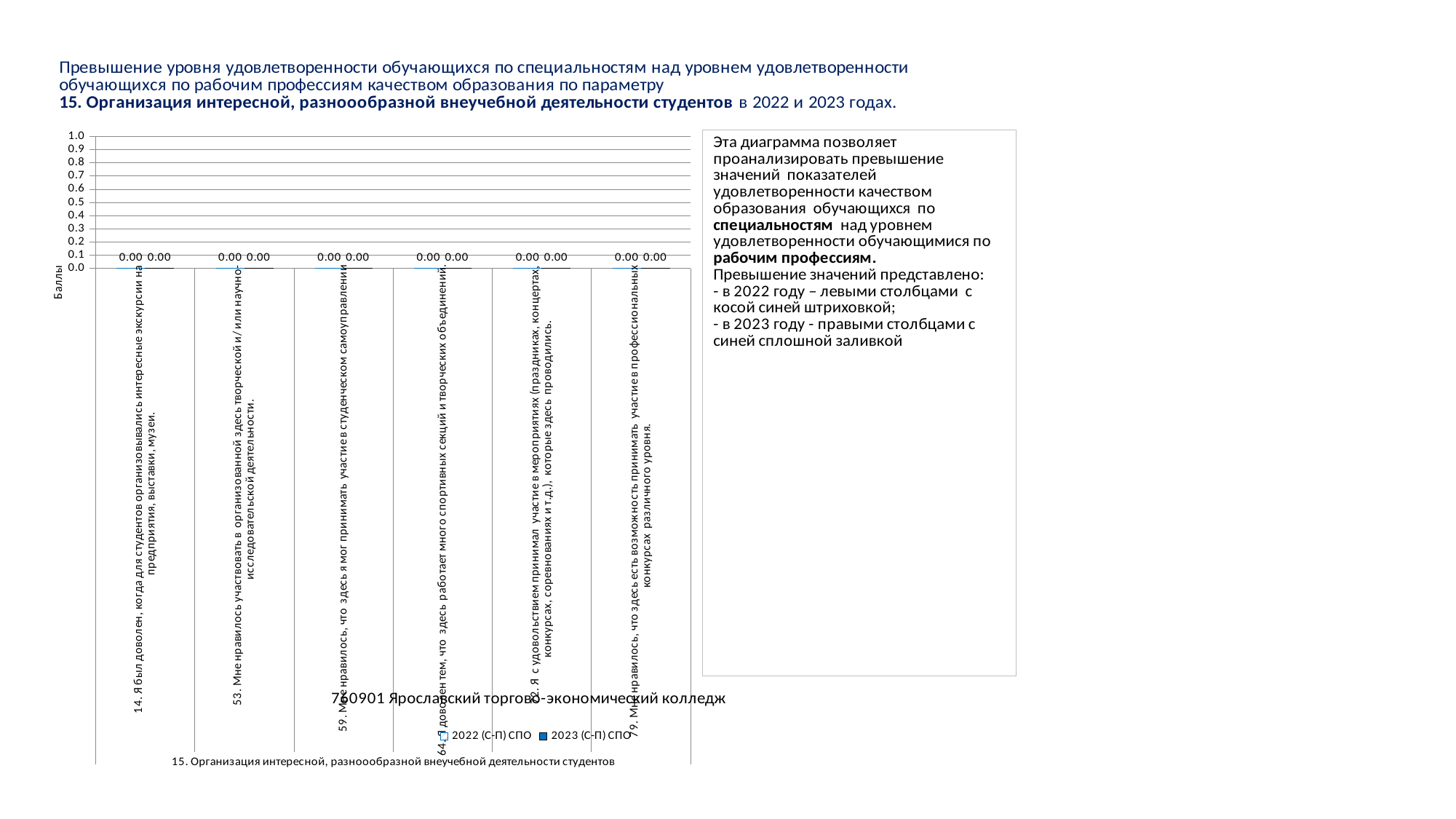
How many categories are plotted along the x axis of the chart? 6 What is the value of the 2023 (С-П) СПО series for category 53 (Мне нравилось участвовать в организованной здесь творческой и/или научно-исследовательской деятельности)? 0.00 Is the 2022 (С-П) СПО value for category 59 (Мне нравилось, что здесь я мог принимать участие в студенческом самоуправлении) greater or less than 0.5? less What is the value of the 2022 (С-П) СПО series for category 79 (Мне нравилось, что здесь есть возможность принимать участие в профессиональных конкурсах различного уровня)? 0.00 How many series does the chart legend list? 2 What is the difference between the 2022 (С-П) СПО and 2023 (С-П) СПО values for category 72 (Я с удовольствием принимал участие в мероприятиях)? 0.00 What kind of chart is shown on the slide? bar chart What are the two legend entries of the chart? 2022 (С-П) СПО and 2023 (С-П) СПО What is the value of the 2023 (С-П) СПО series for category 64 (Я доволен тем, что здесь работает много спортивных секций и творческих объединений)? 0.00 What is the title of the vertical axis of the chart? Баллы What is the highest value shown on the vertical axis of the chart? 1.0 What is the value of the 2022 (С-П) СПО series for category 14 (Я был доволен, когда для студентов организовывались интересные экскурсии на предприятия, выставки, музеи)? 0.00